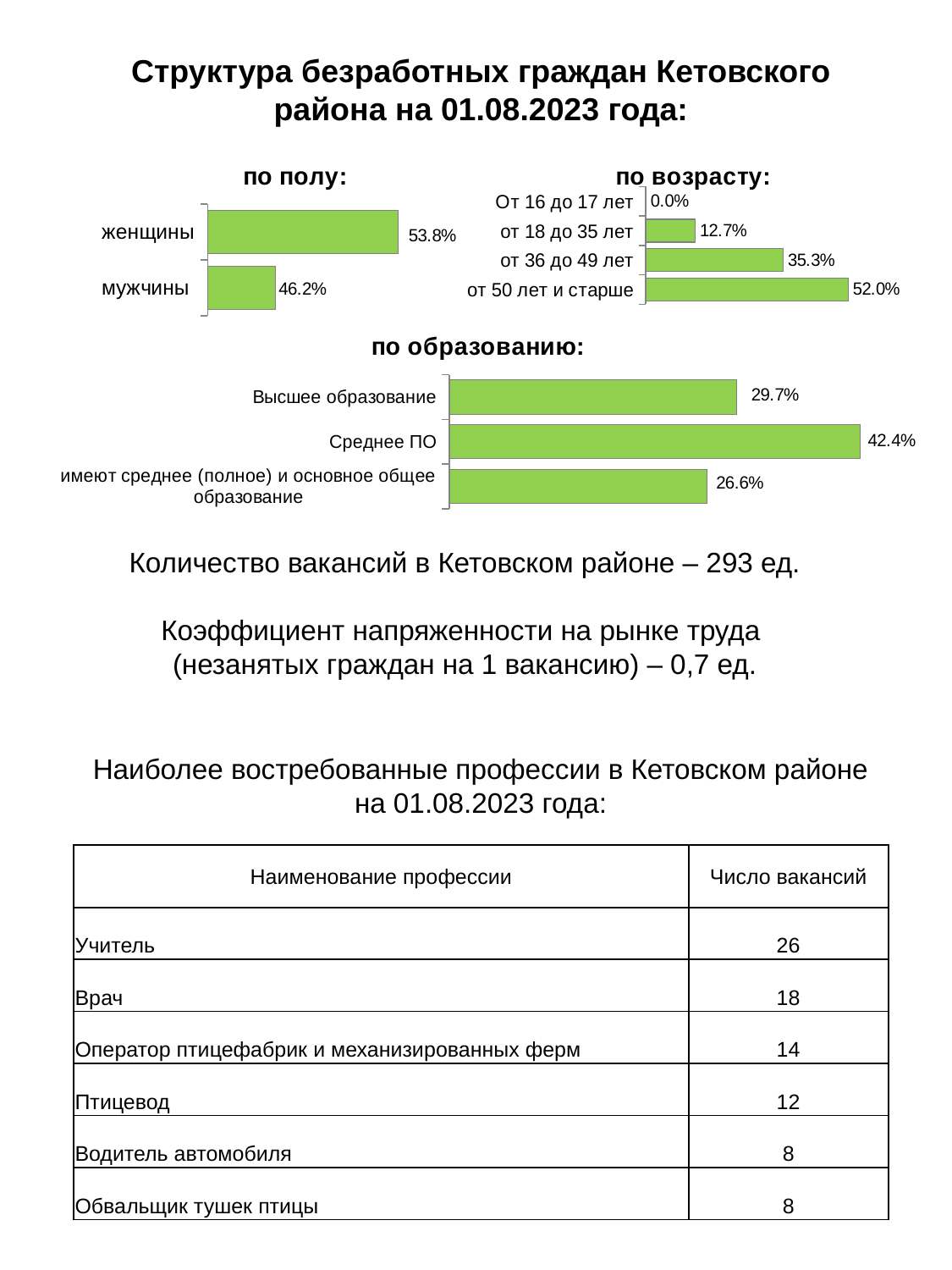
In the chart titled "по образованию:", which is larger: the value for Высшее образование or the value for имеют среднее (полное) и основное общее образование? Высшее образование In the chart titled "по полу:", what is the value for женщины? 53.8% In the chart titled "по возрасту:", what is the value for от 36 до 49 лет? 35.3% In the chart titled "по возрасту:", which age group has the lowest value? От 16 до 17 лет In the chart titled "по возрасту:", how many age categories are shown? 4 What kind of chart is the one titled "по образованию:"? Bar chart In the chart titled "по возрасту:", which age group has the highest value? от 50 лет и старше In the chart titled "по возрасту:", what is the difference between the values for от 50 лет и старше and от 18 до 35 лет? 39.3% How many charts are shown on the slide? 3 In the chart titled "по образованию:", which category has the highest value? Среднее ПО In the chart titled "по полу:", what is the difference between the values for женщины and мужчины? 7.6% In the chart titled "по образованию:", what is the value for Высшее образование? 29.7%